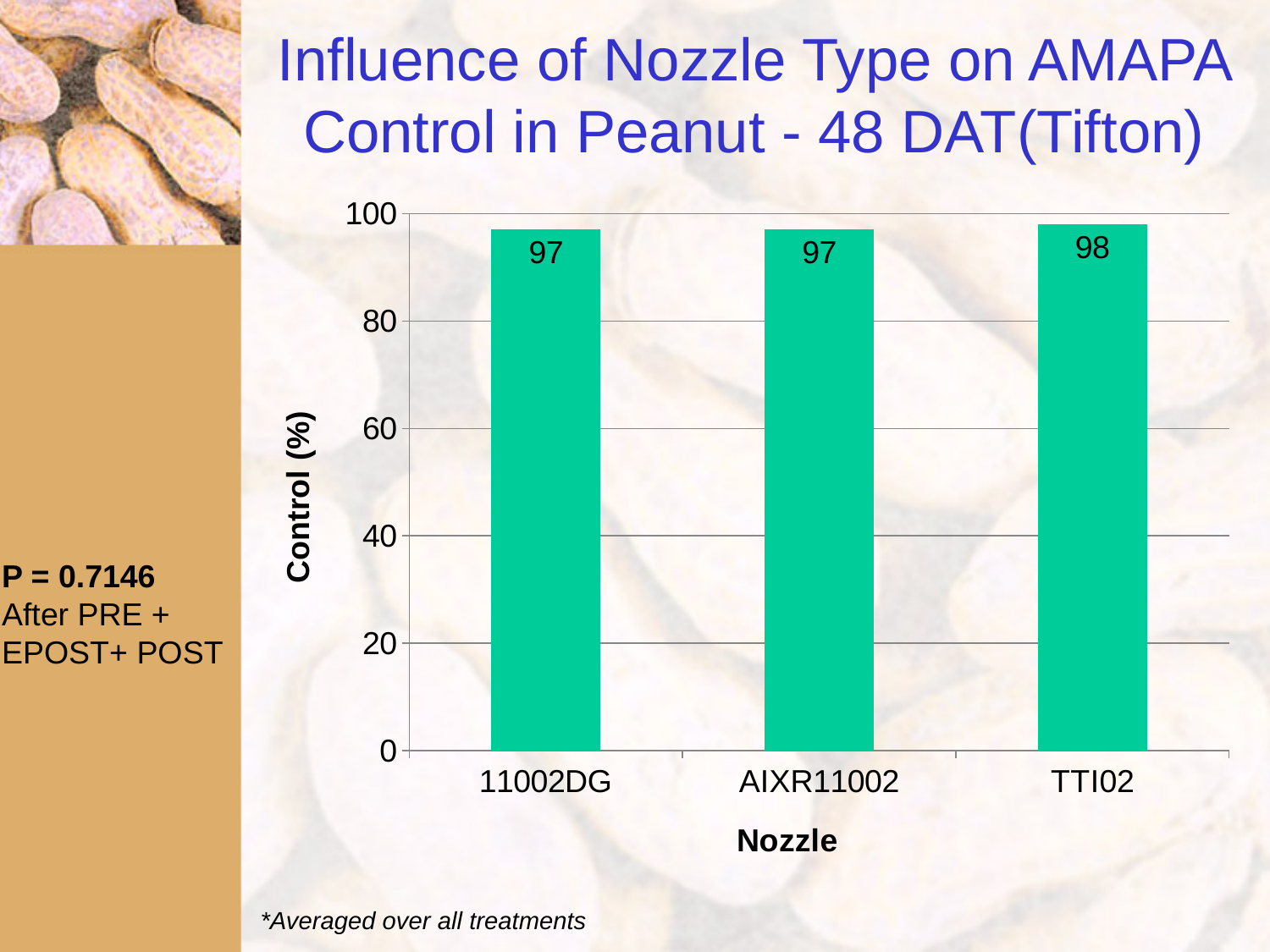
What is the difference in control (%) between TTI02 and 11002DG? 1 What is the title of the x axis? Nozzle Which nozzle has the highest control (%) value? TTI02 Is the value for AIXR11002 greater or less than 80? greater What is the control (%) value for the TTI02 nozzle? 98 What kind of chart is shown on the slide? bar chart What is the title of the y axis? Control (%) How many nozzle types are shown on the x axis? 3 What is the control (%) value for the AIXR11002 nozzle? 97 Which has a larger control (%) value, TTI02 or AIXR11002? TTI02 What is the control (%) value for the 11002DG nozzle? 97